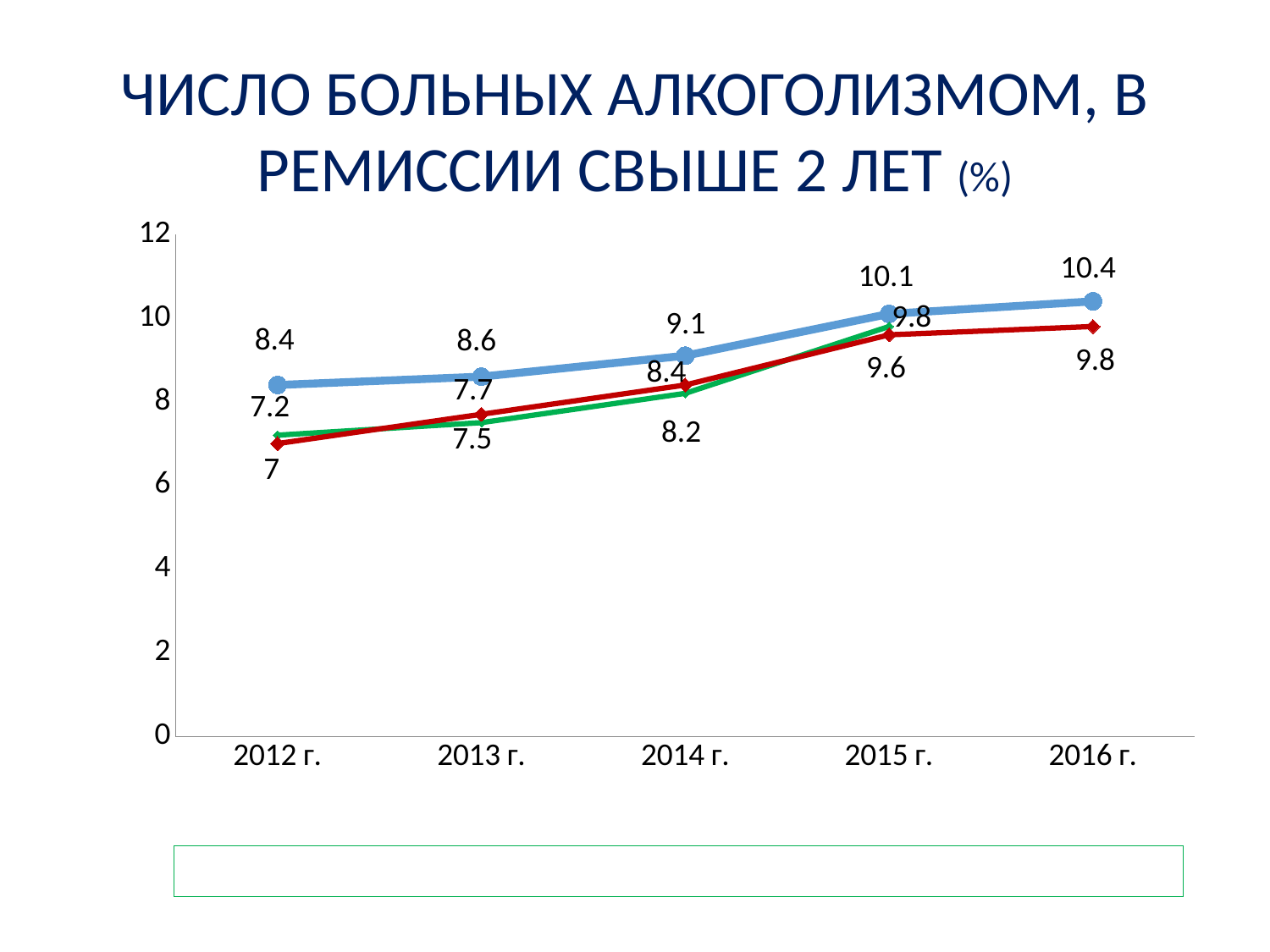
Does the blue line rise or fall from 2012 г. to 2016 г.? rise What is the value of the blue line in 2016 г.? 10.4 Which is larger in 2015 г., the blue line's value or the red line's value? the blue line (10.1) By how much did the blue line's value increase from 2012 г. to 2016 г.? 2 Is the value of the red line in 2012 г. greater or less than 8? less In which year does the blue line have its lowest value? 2012 г. What is the value of the red line in 2016 г.? 9.8 What is the value of the blue line in 2012 г.? 8.4 In which year does the blue line reach its highest value? 2016 г. How many years are shown on the x axis? 5 What kind of chart is shown on the slide? line chart What is the value of the blue line in 2014 г.? 9.1